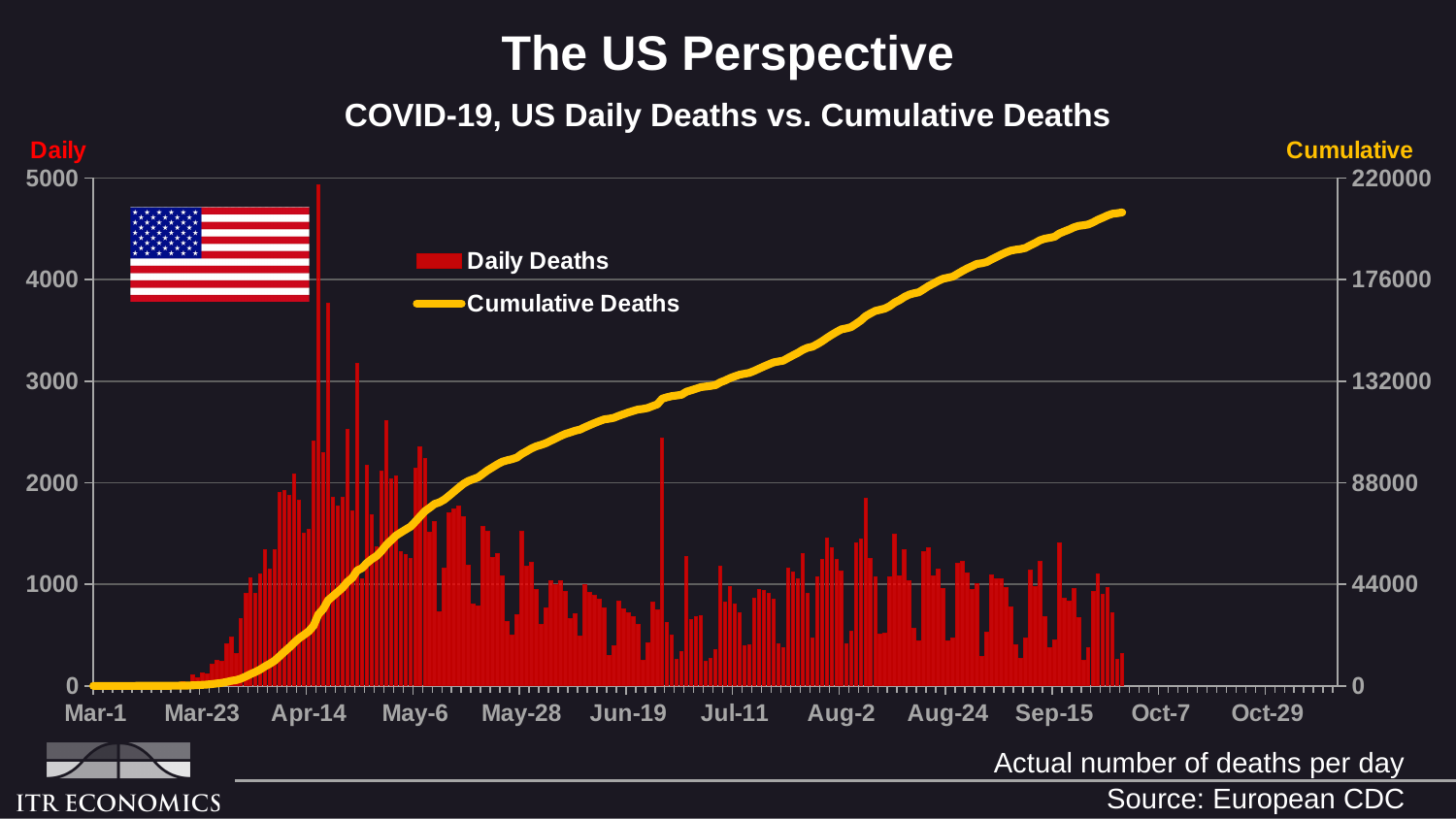
What is the maximum value shown on the right-hand Cumulative axis? 220000 How many date labels are shown along the x axis? 12 What is the title of the chart? COVID-19, US Daily Deaths vs. Cumulative Deaths Is the Cumulative Deaths value at Jun-19 greater or less than 88000? greater Does the Cumulative Deaths line rise or fall from Mar-1 to the end of the data? Rises Is the Cumulative Deaths value at the end of the plotted line greater or less than 176000? greater Is the Cumulative Deaths value at Apr-14 greater or less than 44000? less What are the two series named in the legend? Daily Deaths and Cumulative Deaths What kind of chart is shown on the slide? A combination chart with bars and a line How many series does the legend list? 2